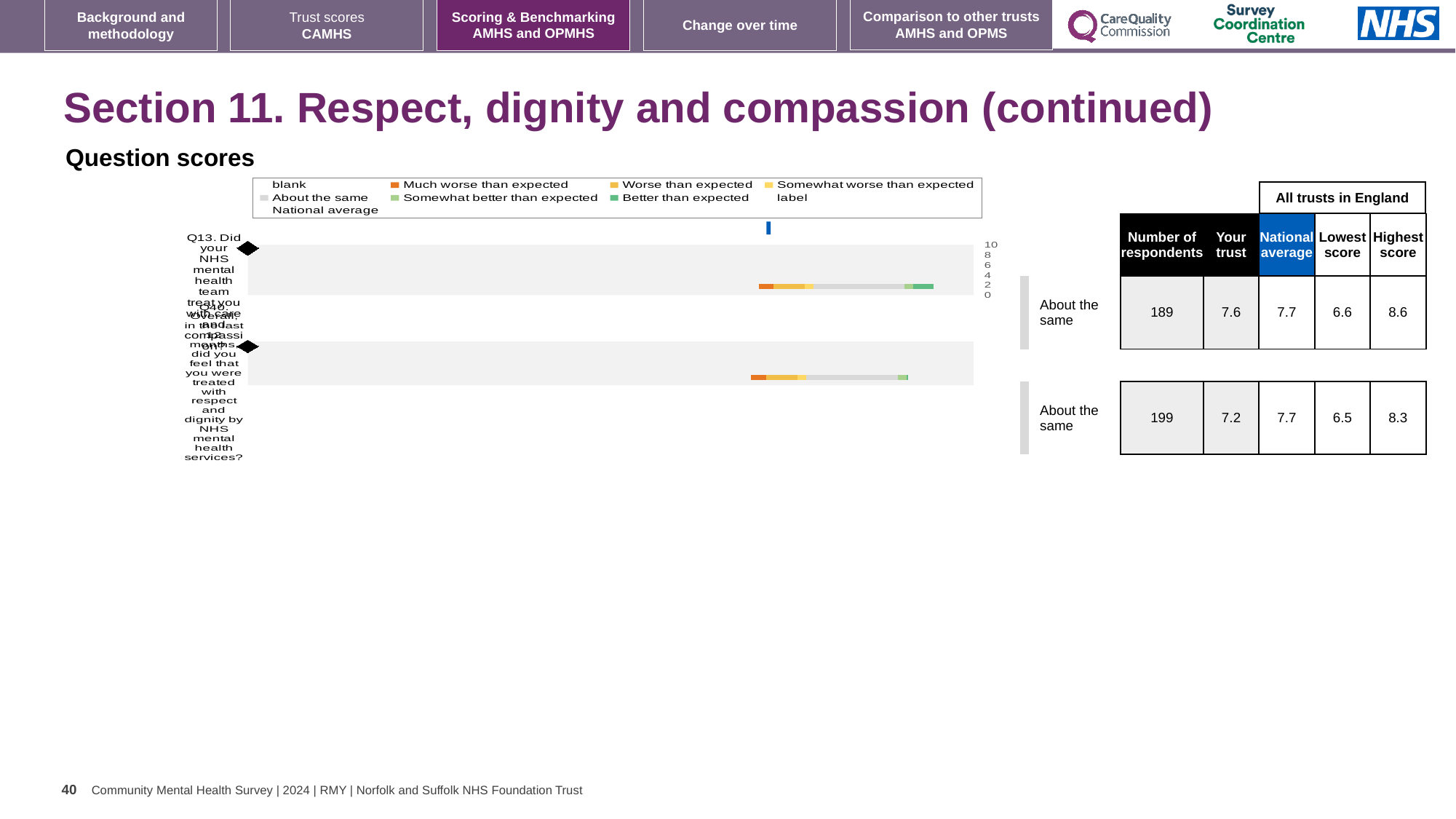
In the table beside the chart, what is the national average for Q10 (the bottom row)? 7.7 In the table beside the chart, what is the highest score for Q10 (the bottom row)? 8.3 How many questions are plotted in the 'Question scores' chart? 2 Which question has the higher 'Your trust' score, Q13 or Q10? Q13 What is the difference between the highest score and the lowest score for Q13 (the top row)? 2.0 What benchmark category is shown next to both questions in the chart? About the same In the table beside the chart, what is the 'Your trust' score for Q13 (the top row)? 7.6 In the table beside the chart, what is the 'Your trust' score for Q10 (the bottom row)? 7.2 Which two questions are plotted in the 'Question scores' chart? Q13 and Q10 How many entries does the legend of the 'Question scores' chart list? 9 What kind of chart is shown under the heading 'Question scores'? bar chart In the table beside the chart, what is the number of respondents for Q13 (the top row)? 189